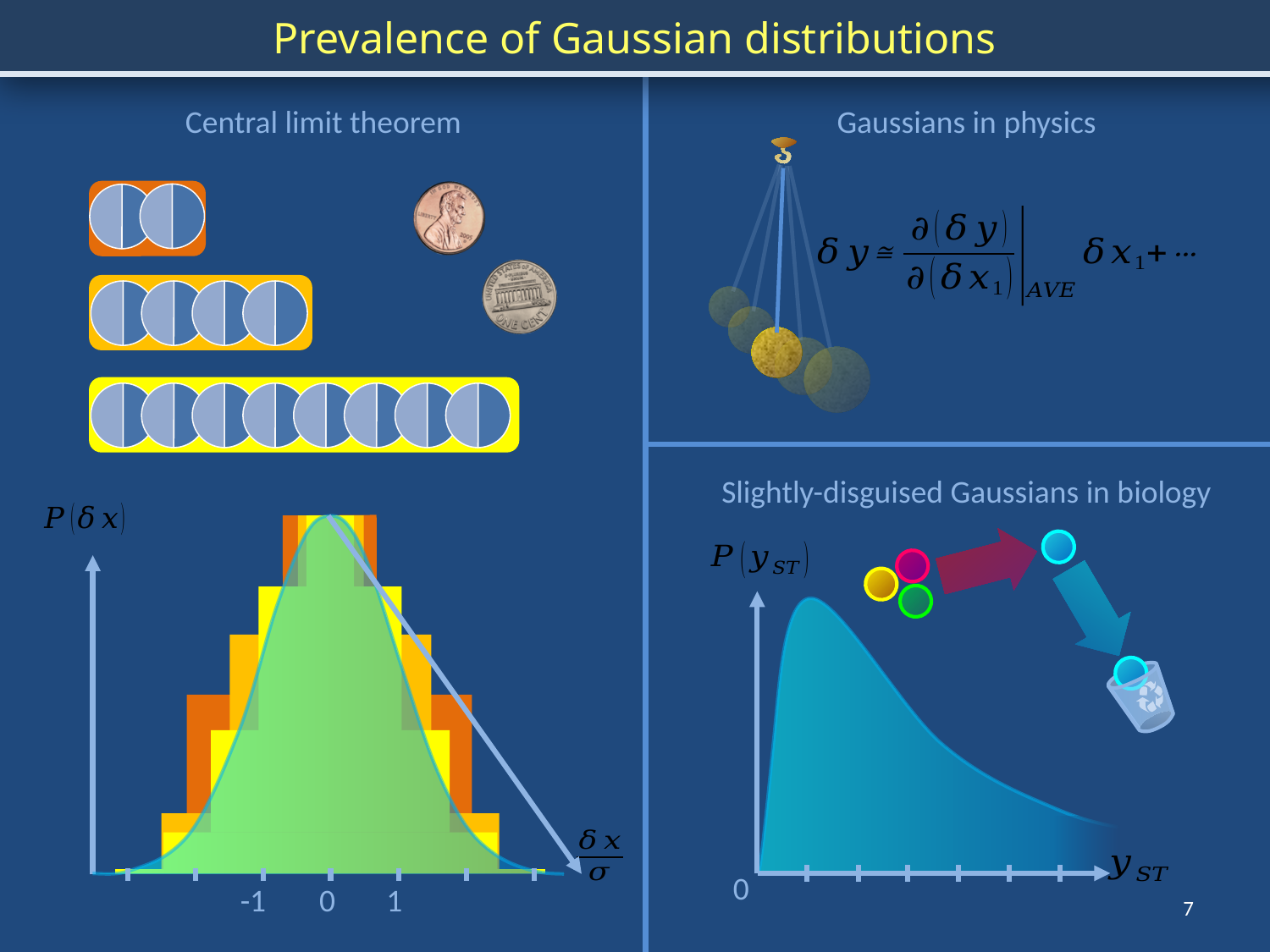
In the Central limit theorem chart, at which x-axis value does the distribution reach its peak? 0 In the Central limit theorem chart, how do the values change as x moves from 0 to 1? They fall In the Slightly-disguised Gaussians in biology chart, how do the values change as y_ST increases beyond the peak? They fall What kind of chart is the Central limit theorem figure, with the stepped coloured blocks under a smooth curve? Bar chart (histogram) with a curve overlay In the Slightly-disguised Gaussians in biology chart, what value is labelled at the origin of the x axis? 0 What is the y-axis label of the Slightly-disguised Gaussians in biology chart? P(y_ST) In the Central limit theorem chart, how do the values change as x moves from -1 to 0? They rise In the Slightly-disguised Gaussians in biology chart, is the peak located near the left end or the right end of the x axis? Near the left end What is the x-axis label of the Central limit theorem chart? δx/σ In the Central limit theorem chart, is the value at x = 0 larger or smaller than the value at x = 1? larger How many numbered tick labels are shown on the x axis of the Central limit theorem chart? 3 In the Central limit theorem chart, is the value at x = -1 larger or smaller than the value at x = 0? smaller